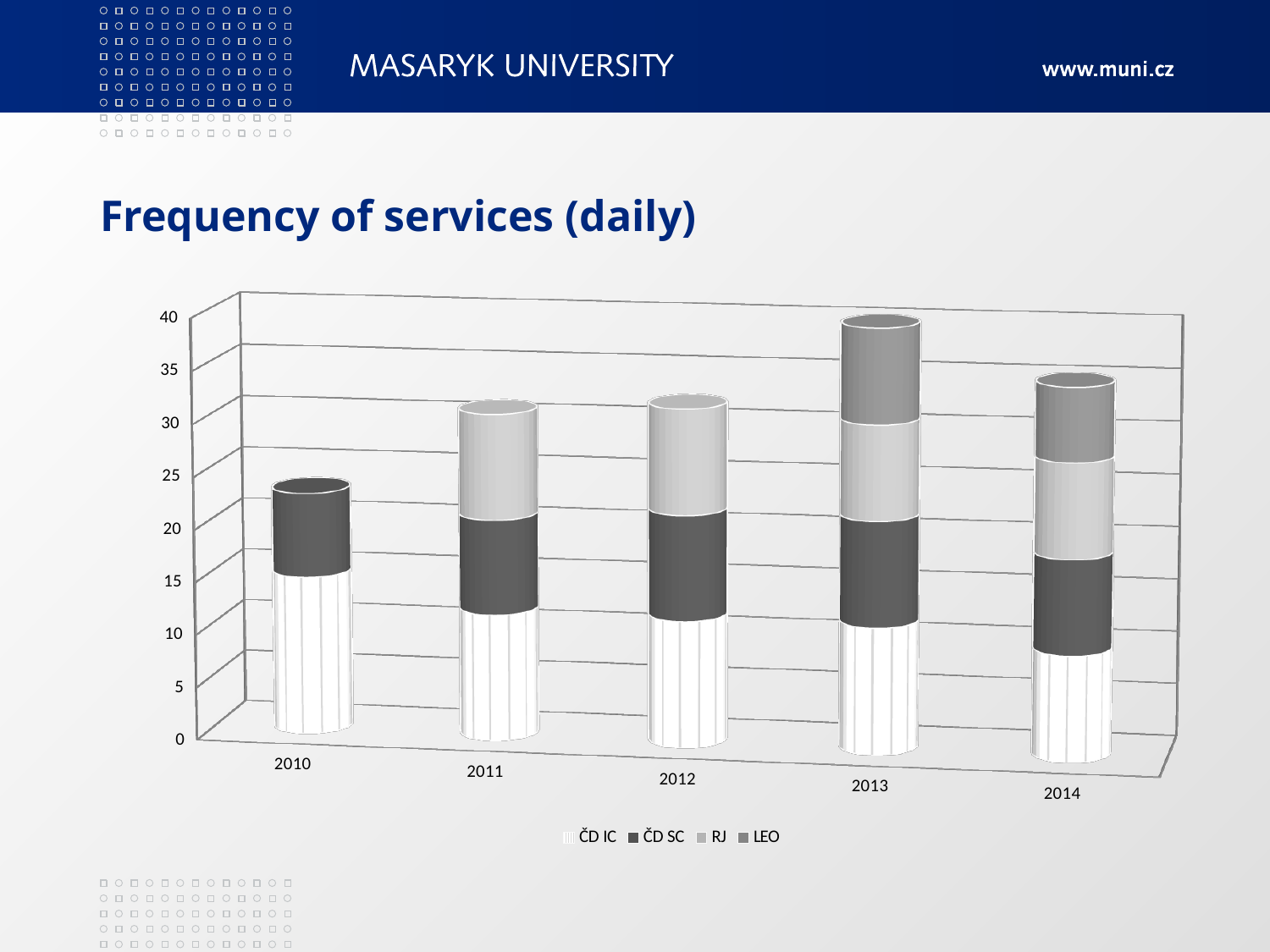
How many series does the legend list? 4 Which year has a larger total, 2013 or 2014? 2013 Is the total for 2010 greater or less than 30? less Is the total for 2014 greater or less than 30? greater How many years are shown on the x axis? 5 Is the total for 2013 greater or less than 35? greater In which year does the LEO series first appear in the chart? 2013 Which year has a larger total, 2010 or 2011? 2011 What kind of chart is shown on the slide? Stacked bar chart Which year has the highest total frequency of services? 2013 Which year has the lowest total frequency of services? 2010 What is the title of the chart? Frequency of services (daily)